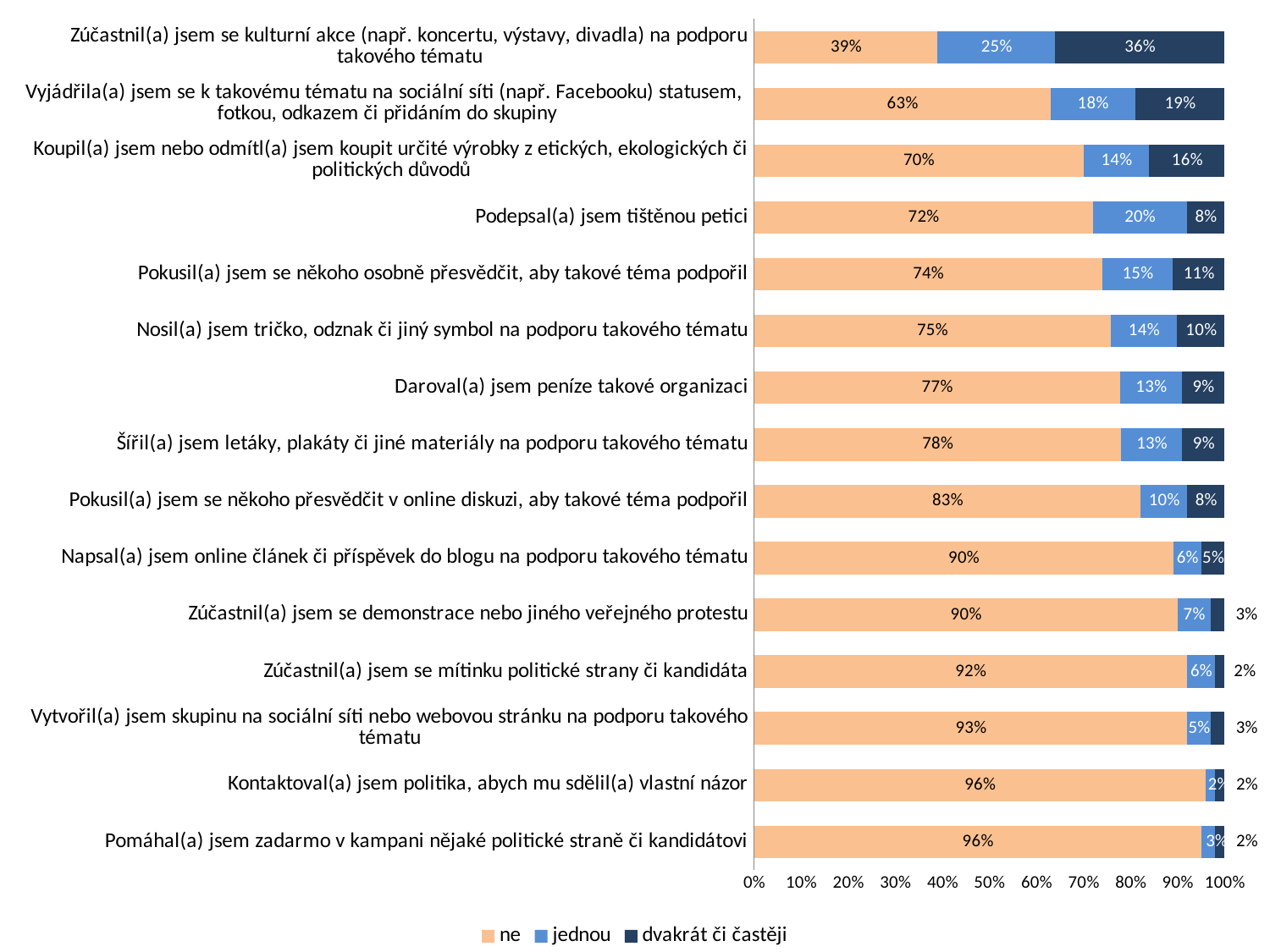
Which category has the lowest value in the 'ne' series? Zúčastnil(a) jsem se kulturní akce (např. koncertu, výstavy, divadla) na podporu takového tématu What is the value of the 'ne' series for 'Podepsal(a) jsem tištěnou petici'? 72% How many series does the legend list? 3 Which category has the highest value in the 'dvakrát či častěji' series? Zúčastnil(a) jsem se kulturní akce (např. koncertu, výstavy, divadla) na podporu takového tématu What kind of chart is shown on the slide? stacked bar chart What is the total of the stacked bar for 'Vyjádřila(a) jsem se k takovému tématu na sociální síti (např. Facebooku) statusem, fotkou, odkazem či přidáním do skupiny'? 100% What is the value of the 'dvakrát či častěji' series for 'Koupil(a) jsem nebo odmítl(a) jsem koupit určité výrobky z etických, ekologických či politických důvodů'? 16% What is the difference between the 'ne' values for 'Pokusil(a) jsem se někoho přesvědčit v online diskuzi, aby takové téma podpořil' and 'Daroval(a) jsem peníze takové organizaci'? 6% How many categories (statements) are plotted on the chart? 15 Which series is shown in the darkest (navy) colour according to the legend? dvakrát či častěji Which is larger: the 'jednou' value for 'Podepsal(a) jsem tištěnou petici' or the 'jednou' value for 'Nosil(a) jsem tričko, odznak či jiný symbol na podporu takového tématu'? Podepsal(a) jsem tištěnou petici What is the value of the 'jednou' series for 'Zúčastnil(a) jsem se kulturní akce (např. koncertu, výstavy, divadla) na podporu takového tématu'? 25%